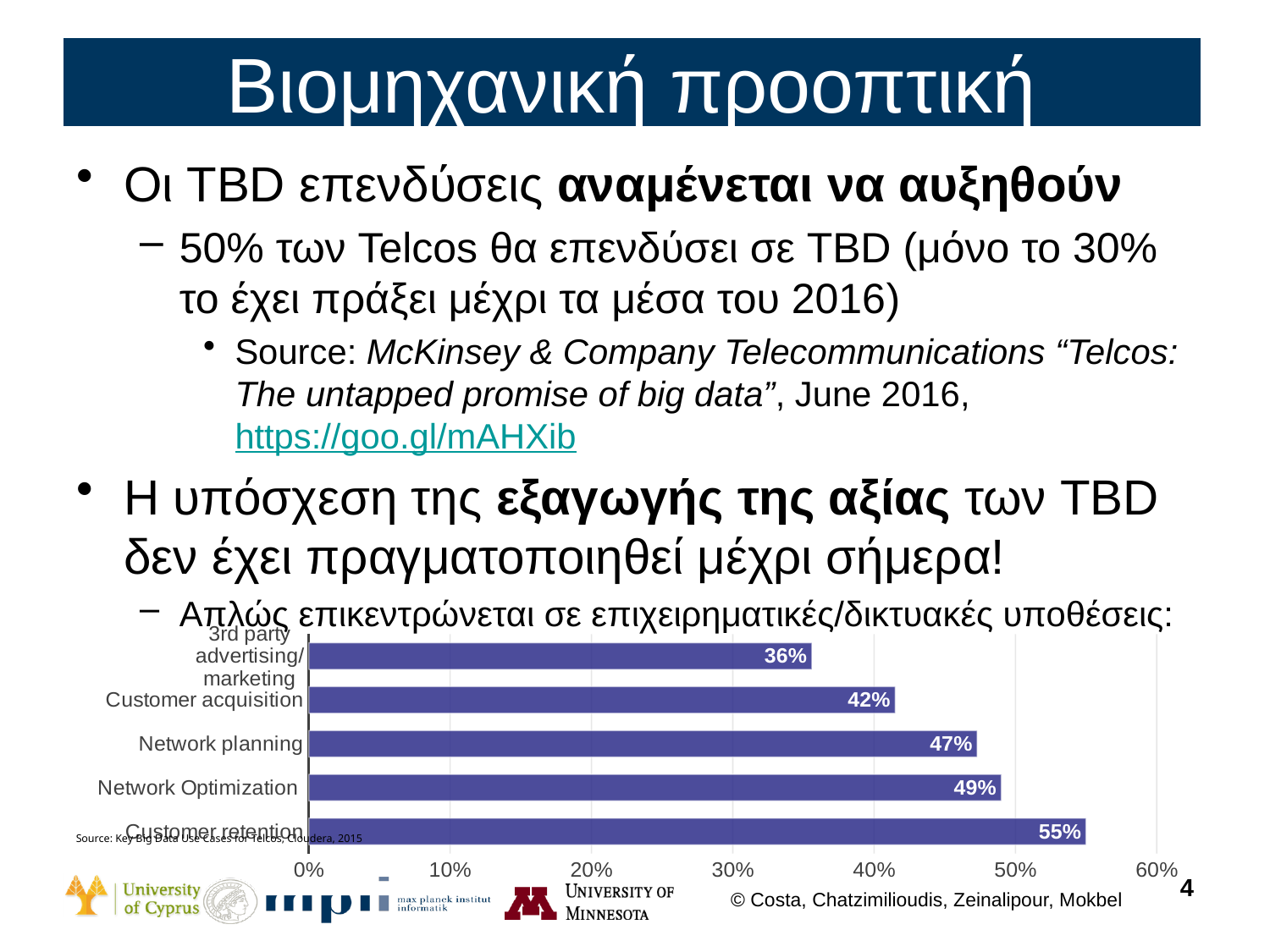
Which is larger, Customer acquisition or Network planning? Network planning Is the value for Network Optimization greater or less than 40%? greater Which category has the lowest value? 3rd party advertising/marketing What kind of chart is shown on the slide? bar chart What is the maximum value shown on the horizontal axis? 60% What is the value for 3rd party advertising/marketing? 36% What is the value for Customer retention? 55% Which category has the highest value? Customer retention What is the difference between Network Optimization and Network planning? 2% What is the difference between Customer retention and Customer acquisition? 13% How many categories are shown in the chart? 5 What is the value for Network planning? 47%